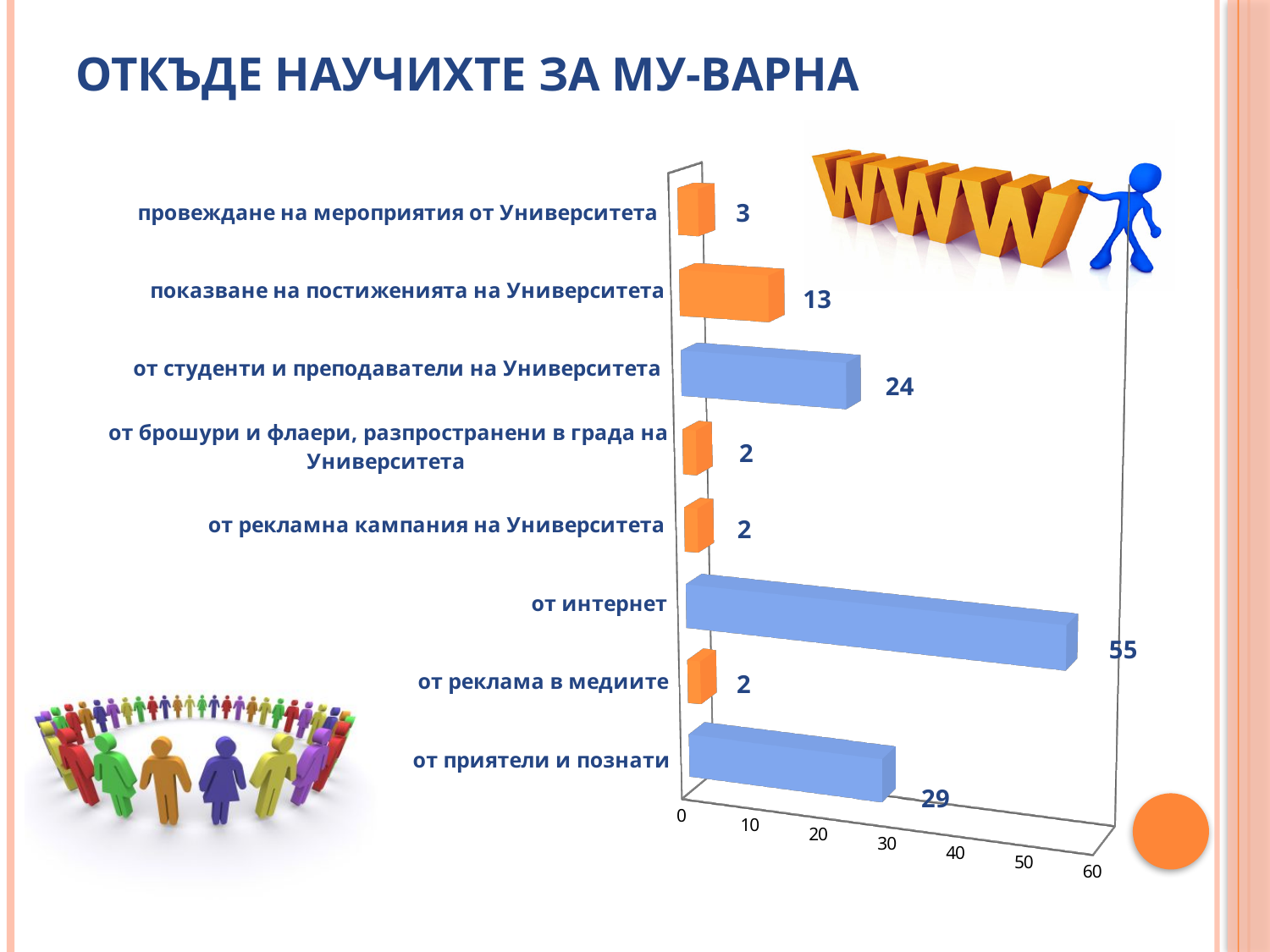
What is the difference between the values for "от интернет" and "от приятели и познати"? 26 What is the value for "от студенти и преподаватели на Университета"? 24 What is the value for "от интернет"? 55 What is the title of the slide containing the chart? ОТКЪДЕ НАУЧИХТЕ ЗА МУ-ВАРНА What kind of chart is shown on the slide? bar chart Which is larger, the value for "от студенти и преподаватели на Университета" or the value for "показване на постиженията на Университета"? от студенти и преподаватели на Университета Is the value for "от интернет" greater or less than 50? greater Which category has the highest value? от интернет How many categories are shown in the chart? 8 What is the value for "провеждане на мероприятия от Университета"? 3 What is the value for "показване на постиженията на Университета"? 13 What is the value for "от приятели и познати"? 29